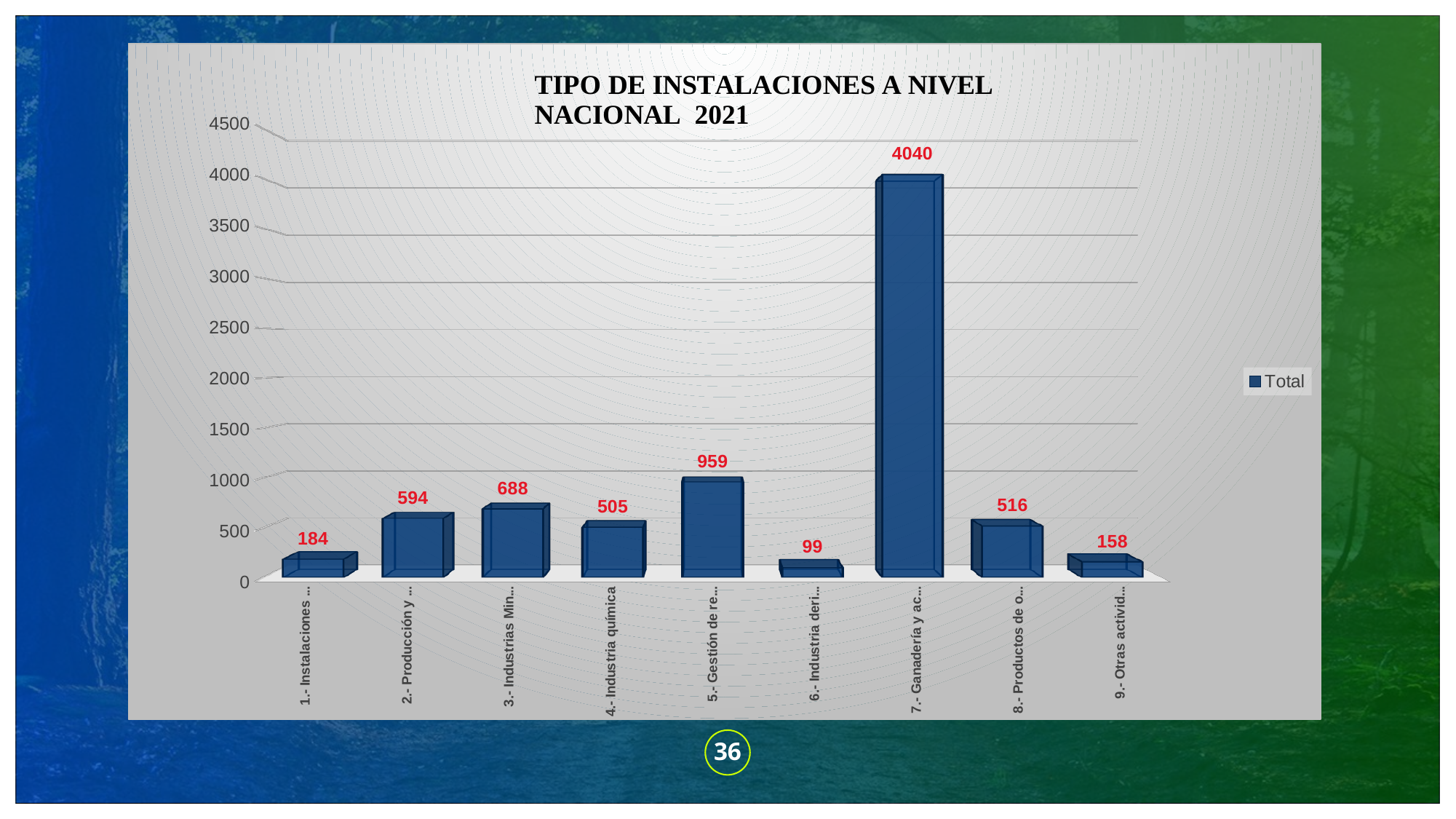
Which is larger, the value for category 2 (Producción y ...) or the value for category 8 (Productos de o...)? 2.- Producción y ... What type of chart is shown on the slide? bar chart Which category has the highest value? 7.- Ganadería y ac... What is the difference between the value for category 5 (Gestión de re...) and the value for category 3 (Industrias Min...)? 271 What is the value for the category '4.- Industria química'? 505 What is the name of the series shown in the legend? Total What is the value for the category numbered 7 (Ganadería y ac...)? 4040 What is the title of the chart? TIPO DE INSTALACIONES A NIVEL NACIONAL 2021 Which category has the lowest value? 6.- Industria deri... How many categories are plotted on the x axis? 9 What is the value for the category numbered 6 (Industria deri...)? 99 How many series does the legend list? 1